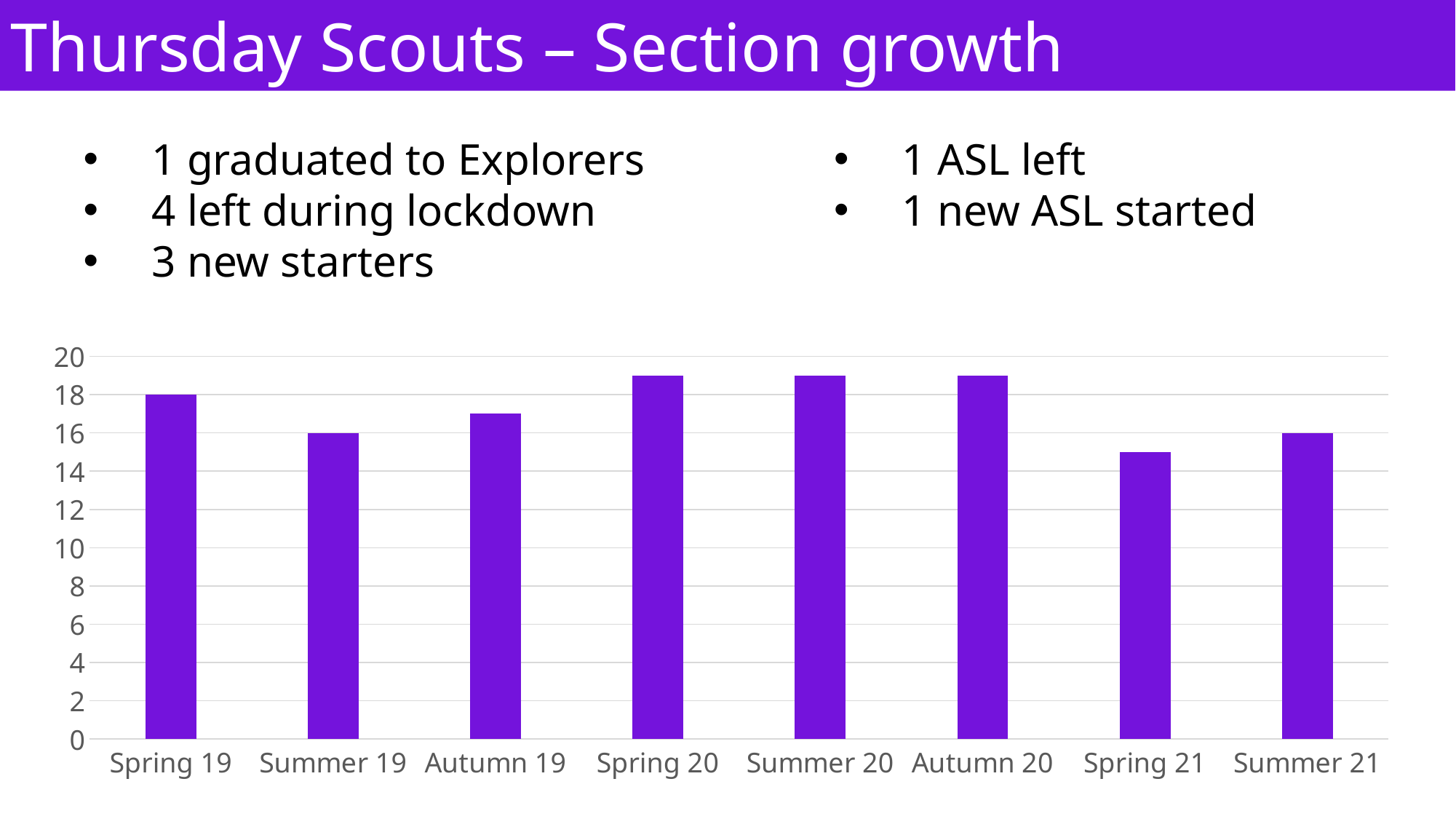
Is the value for Autumn 19 greater or less than 16? greater What is the value for Summer 19? 16 What is the value for Spring 19? 18 Which category has the lowest value? Spring 21 Which is larger, the value for Spring 19 or the value for Summer 19? Spring 19 How many categories are shown on the x axis? 8 What is the difference between the values for Spring 19 and Summer 19? 2 Is the value for Spring 20 greater or less than 18? greater What is the value for Summer 21? 16 What kind of chart is shown on the slide? Bar chart Is the value for Spring 21 greater or less than 16? less